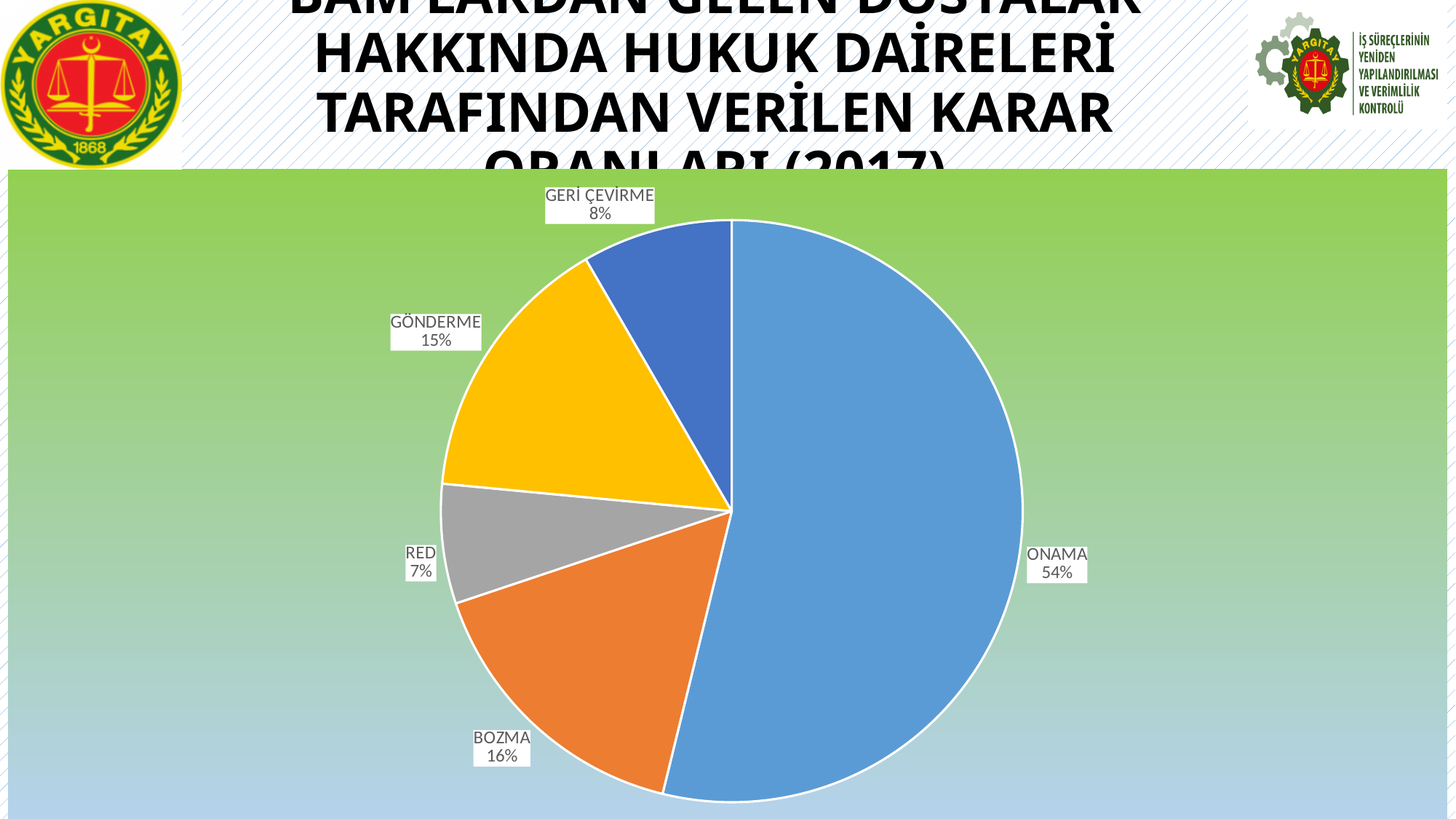
What is the value shown for GERİ ÇEVİRME? 8% What is the value shown for RED? 7% Which is larger, the share for GÖNDERME or the share for GERİ ÇEVİRME? GÖNDERME What share of the pie does ONAMA represent? 54% What is the value shown for GÖNDERME? 15% How many categories are shown in the pie chart? 5 What is the value shown for BOZMA? 16% Which category has the smallest slice of the pie? RED Which category has the largest slice of the pie? ONAMA What kind of chart is shown on the slide? Pie chart What colour is the ONAMA slice? Blue What is the difference in percentage points between ONAMA and BOZMA? 38